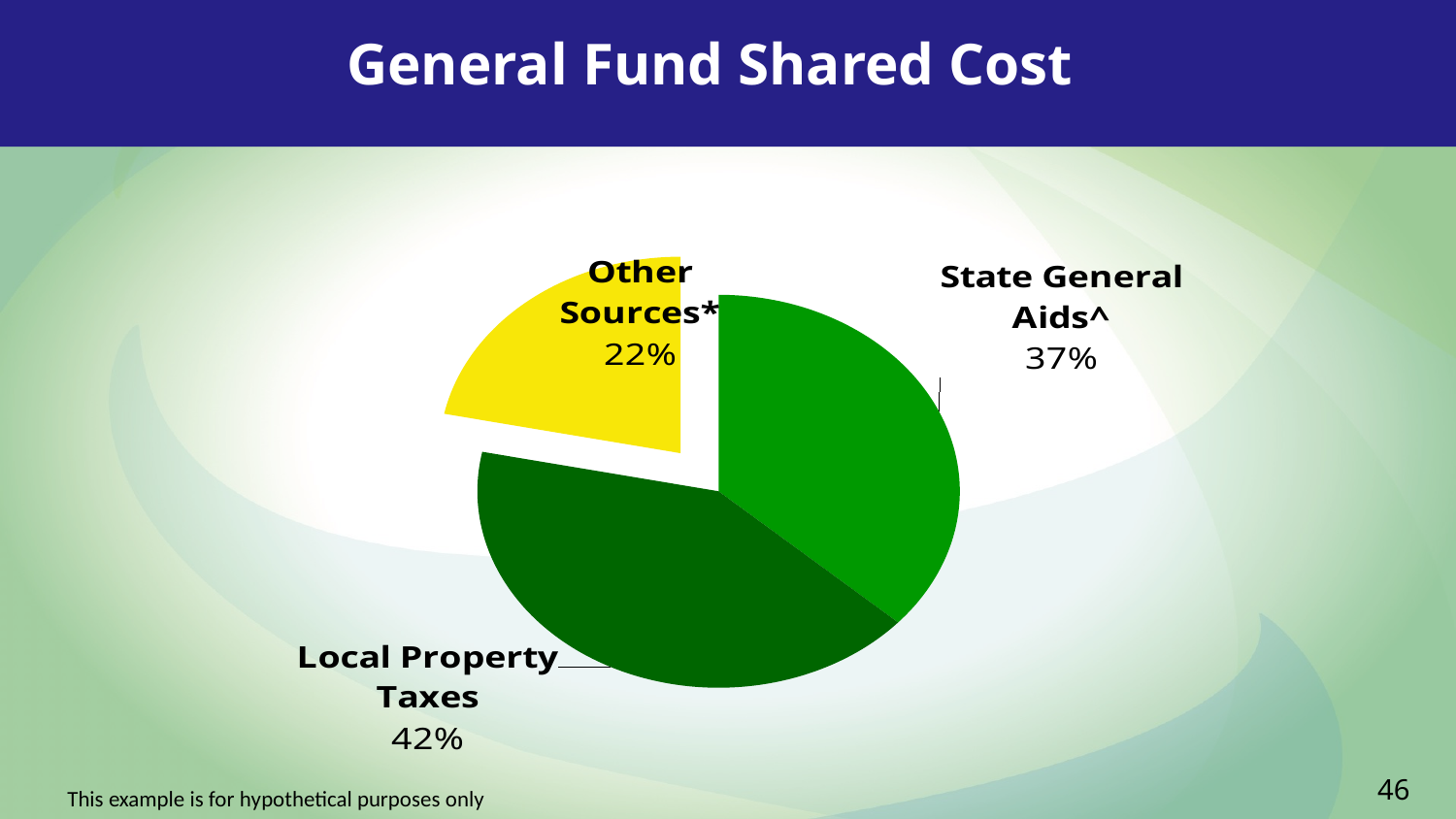
What is the difference in percentage points between State General Aids^ and Other Sources*? 15 What share of the pie is Local Property Taxes? 42% Which slice of the pie is the largest? Local Property Taxes Which is larger, the share for State General Aids^ or the share for Other Sources*? State General Aids^ How many slices does the pie chart have? 3 What share of the pie is State General Aids^? 37% What kind of chart is shown on the slide? pie chart Which slice of the pie is the smallest? Other Sources* What share of the pie is Other Sources*? 22% What colour is the Other Sources* slice? yellow What is the difference in percentage points between Local Property Taxes and State General Aids^? 5 What is the title of the slide containing the pie chart? General Fund Shared Cost